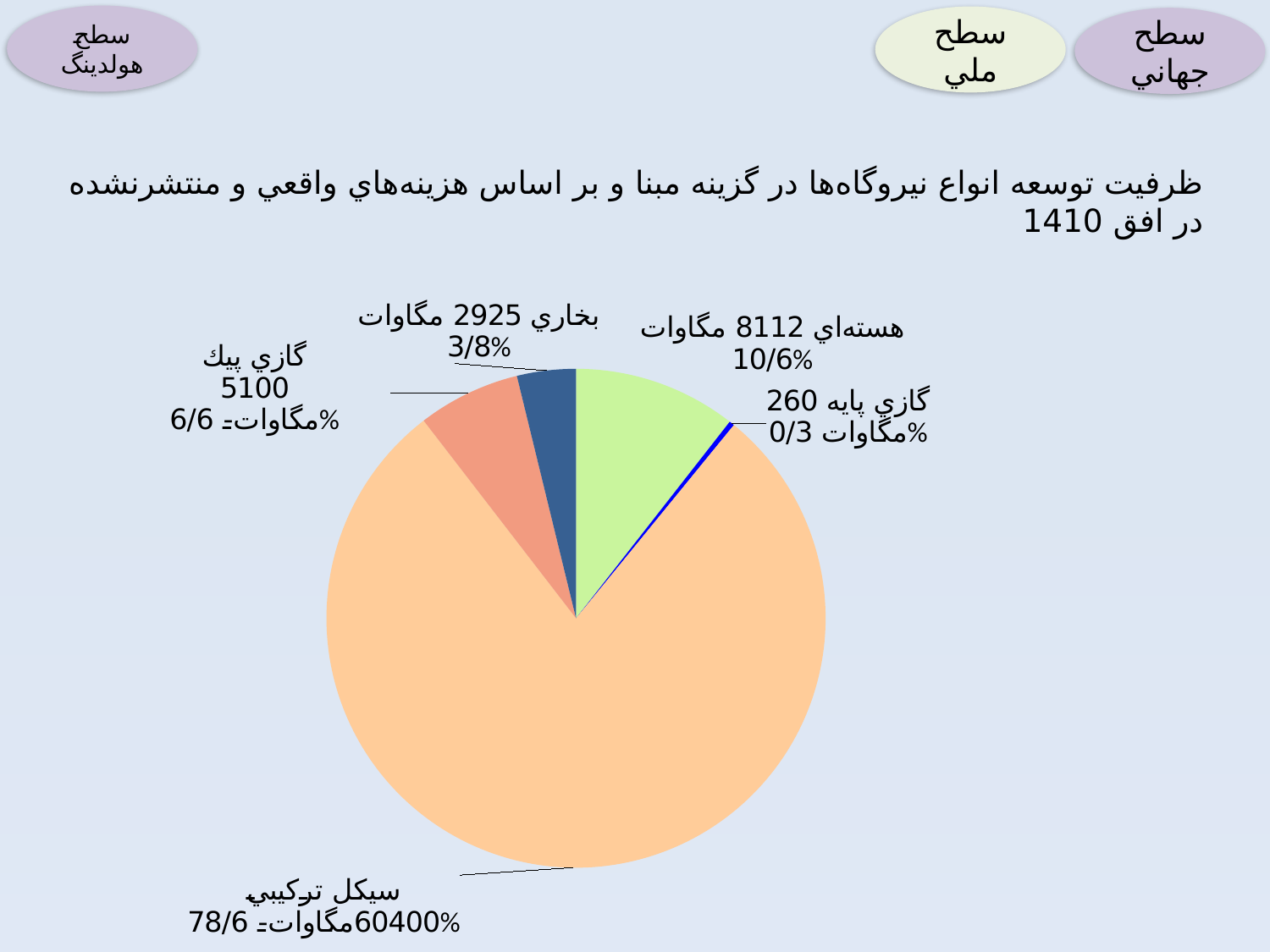
How many slices does the pie chart have? 5 What year (horizon) is mentioned in the chart title? 1410 What is the difference in megawatts between هسته‌اي (8112) and بخاري (2925)? 5187 Which has a larger capacity, گازي پيك or بخاري? گازي پيك What is the capacity in megawatts shown for هسته‌اي (nuclear)? 8112 مگاوات What is the capacity in megawatts shown for بخاري (steam)? 2925 مگاوات What percentage share of the pie does گازي پيك (peak gas) have? 6/6% What percentage share of the pie does گازي پايه (base gas) have? 0/3% What kind of chart is shown on the slide? pie chart Which category has the largest slice of the pie? سيكل تركيبي What is the capacity in megawatts shown for سيكل تركيبي (combined cycle)? 60400 مگاوات Which category has the smallest slice of the pie? گازي پايه